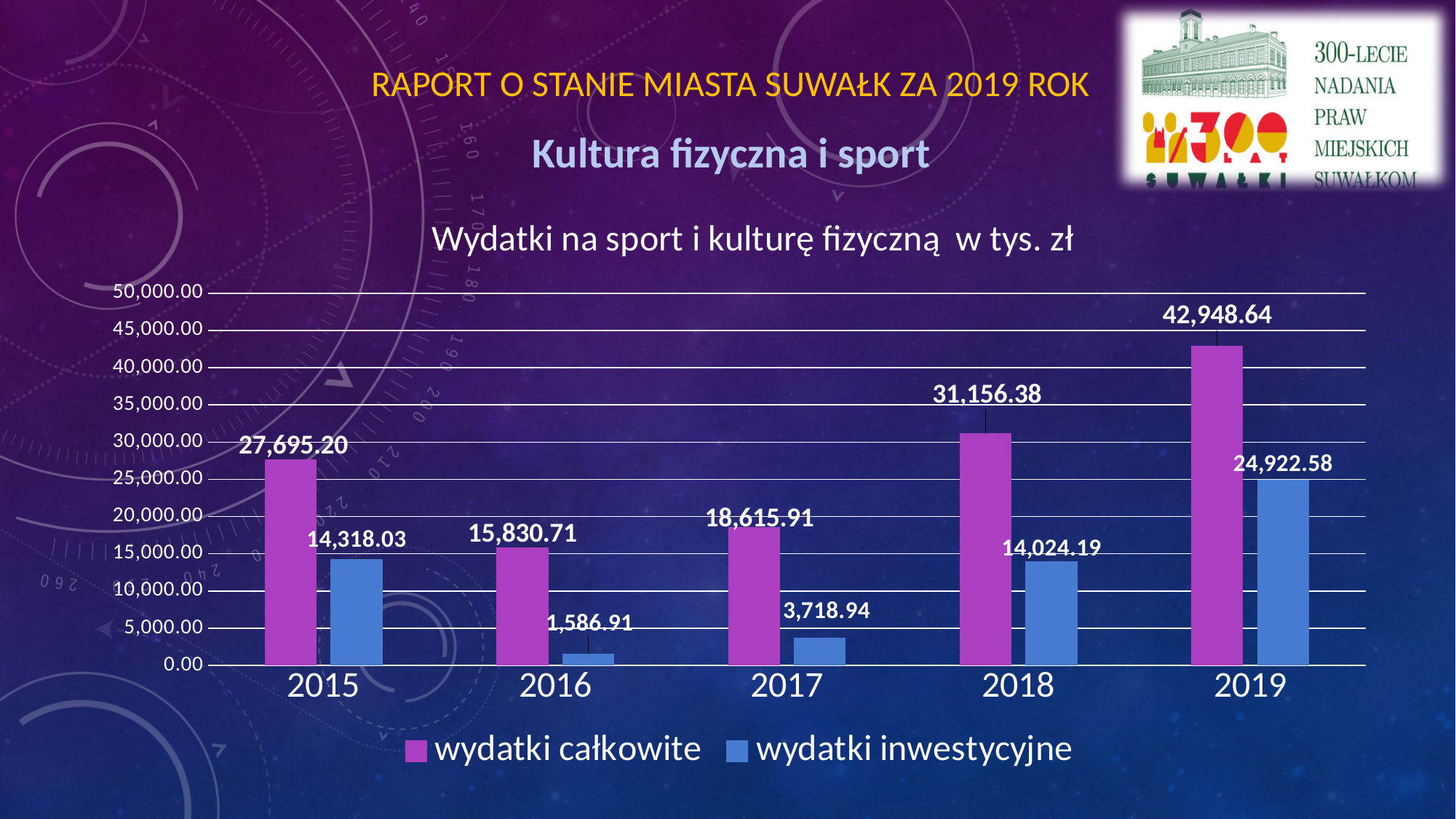
Which is larger: wydatki inwestycyjne in 2015 or in 2018? 2015 Which year has the lowest value of wydatki inwestycyjne? 2016 Which year has the highest value of wydatki całkowite? 2019 What is the difference between wydatki całkowite and wydatki inwestycyjne in 2019? 18,026.06 What is the value of wydatki inwestycyjne for 2016? 1,586.91 What type of chart is shown on the slide? bar chart What is the difference between wydatki całkowite in 2019 and in 2018? 11,792.26 How many series does the legend list? 2 Is the value of wydatki całkowite for 2017 greater or less than 20,000.00? less What is the value of wydatki inwestycyjne for 2018? 14,024.19 What is the value of wydatki całkowite for 2019? 42,948.64 How many years are shown on the x axis of the chart? 5